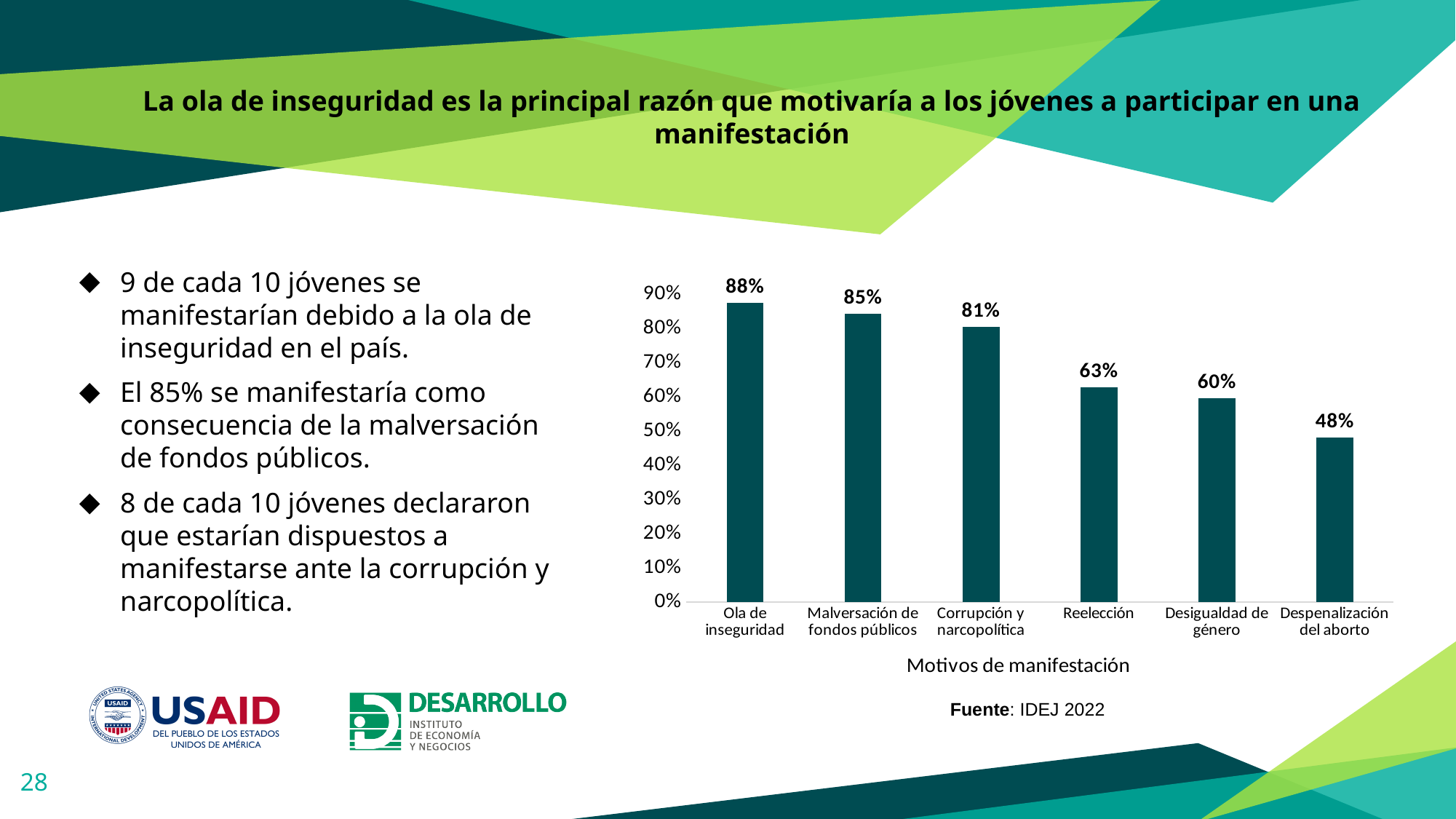
How many categories are shown on the x axis? 6 What is the value for Despenalización del aborto? 48% What is the value for Reelección? 63% Which category has the highest value? Ola de inseguridad Is the value for Desigualdad de género greater or less than 50%? greater What is the difference between the values for Malversación de fondos públicos and Corrupción y narcopolítica? 4% What is the x-axis title of the chart? Motivos de manifestación What is the value for Ola de inseguridad? 88% Which category has the lowest value? Despenalización del aborto Which is larger, the value for Reelección or the value for Desigualdad de género? Reelección Do the values rise or fall from left to right along the x axis? Fall What kind of chart is shown on the slide? Bar chart